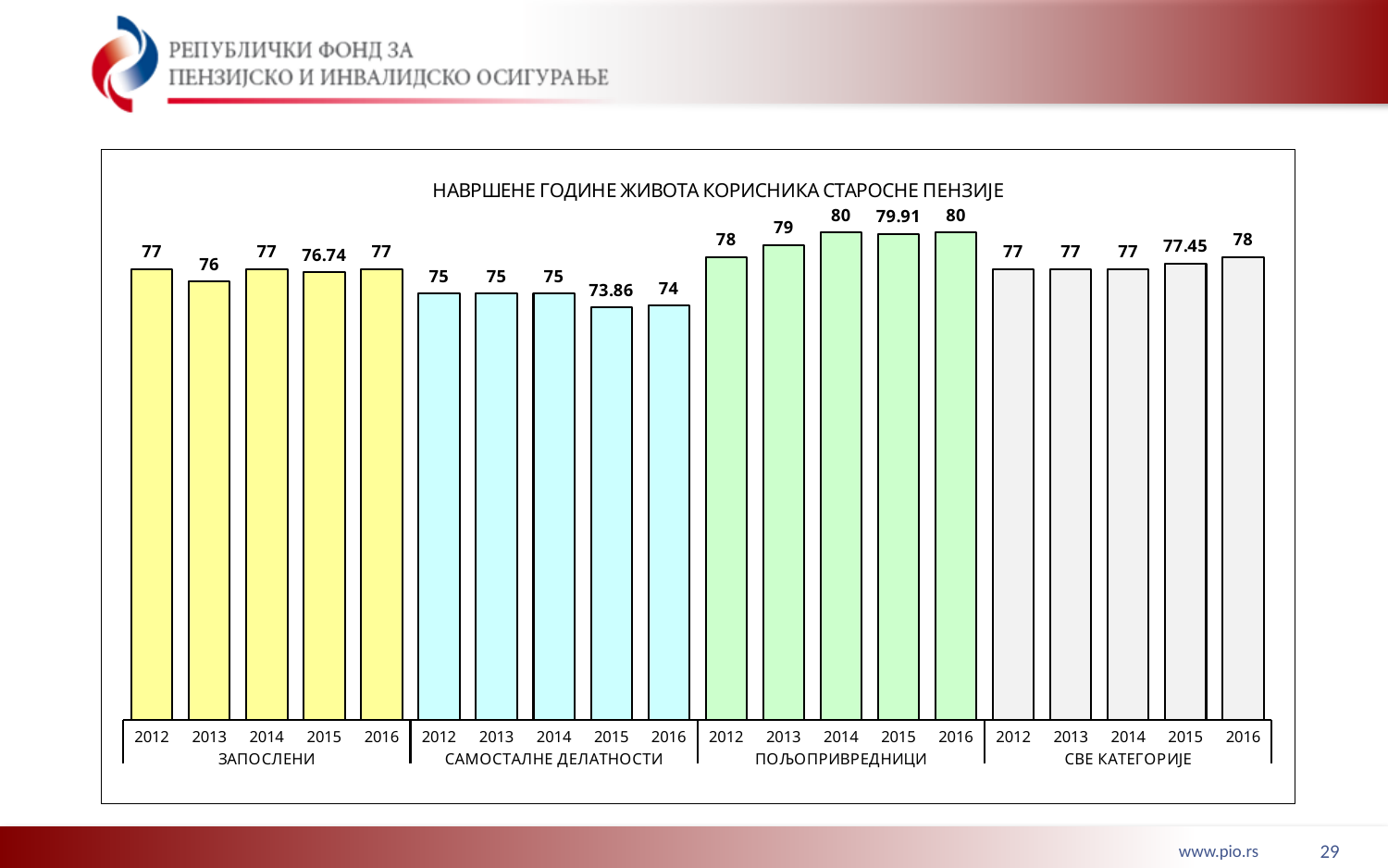
What is the title of the chart? НАВРШЕНЕ ГОДИНЕ ЖИВОТА КОРИСНИКА СТАРОСНЕ ПЕНЗИЈЕ How many category groups are shown along the x axis? 4 Which is larger: the ЗАПОСЛЕНИ value in 2012 or the САМОСТАЛНЕ ДЕЛАТНОСТИ value in 2012? ЗАПОСЛЕНИ value in 2012 What is the difference between the ПОЉОПРИВРЕДНИЦИ value in 2016 and the САМОСТАЛНЕ ДЕЛАТНОСТИ value in 2016? 6 What is the value for ЗАПОСЛЕНИ in 2013? 76 What kind of chart is shown on the slide? Bar chart What is the value for СВЕ КАТЕГОРИЈЕ in 2016? 78 Which group has the highest values overall in the chart? ПОЉОПРИВРЕДНИЦИ Which year has the lowest value in the САМОСТАЛНЕ ДЕЛАТНОСТИ group? 2015 How many bars are plotted in the chart in total? 20 What is the value for ПОЉОПРИВРЕДНИЦИ in 2015? 79.91 What is the value for САМОСТАЛНЕ ДЕЛАТНОСТИ in 2015? 73.86